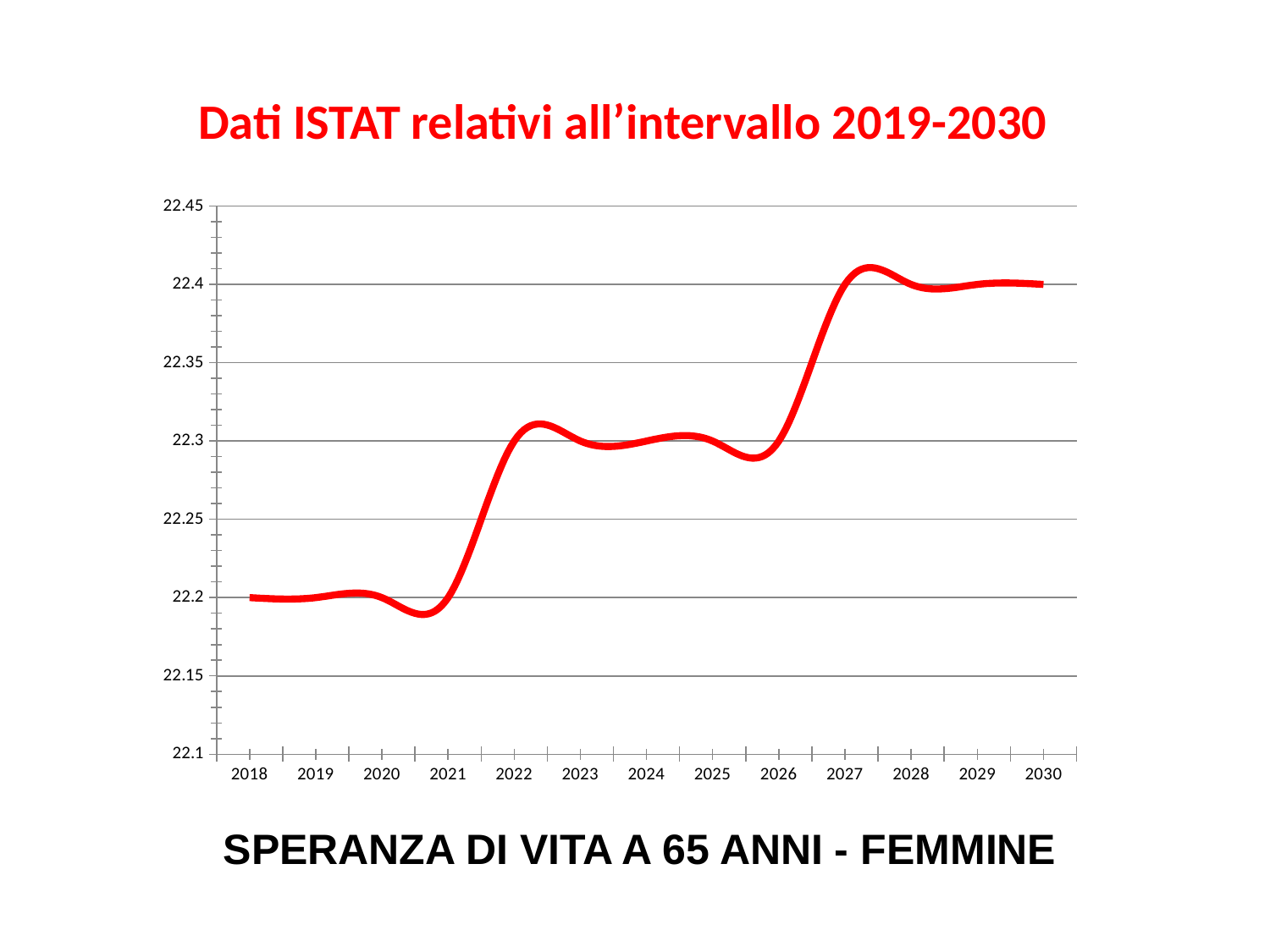
Is the value for 2023 greater or less than 22.35? less How many years are plotted along the x axis? 13 What colour is the plotted line? red Which is larger, the value for 2030 or the value for 2018? 2030 Do the values generally rise or fall from 2018 to 2030? rise What is the value for 2030? 22.4 Is the value for 2028 greater or less than 22.35? greater What is the title printed below the chart? SPERANZA DI VITA A 65 ANNI - FEMMINE Is the value for 2019 greater or less than 22.25? less What kind of chart is shown on the slide? line chart What is the value for 2018? 22.2